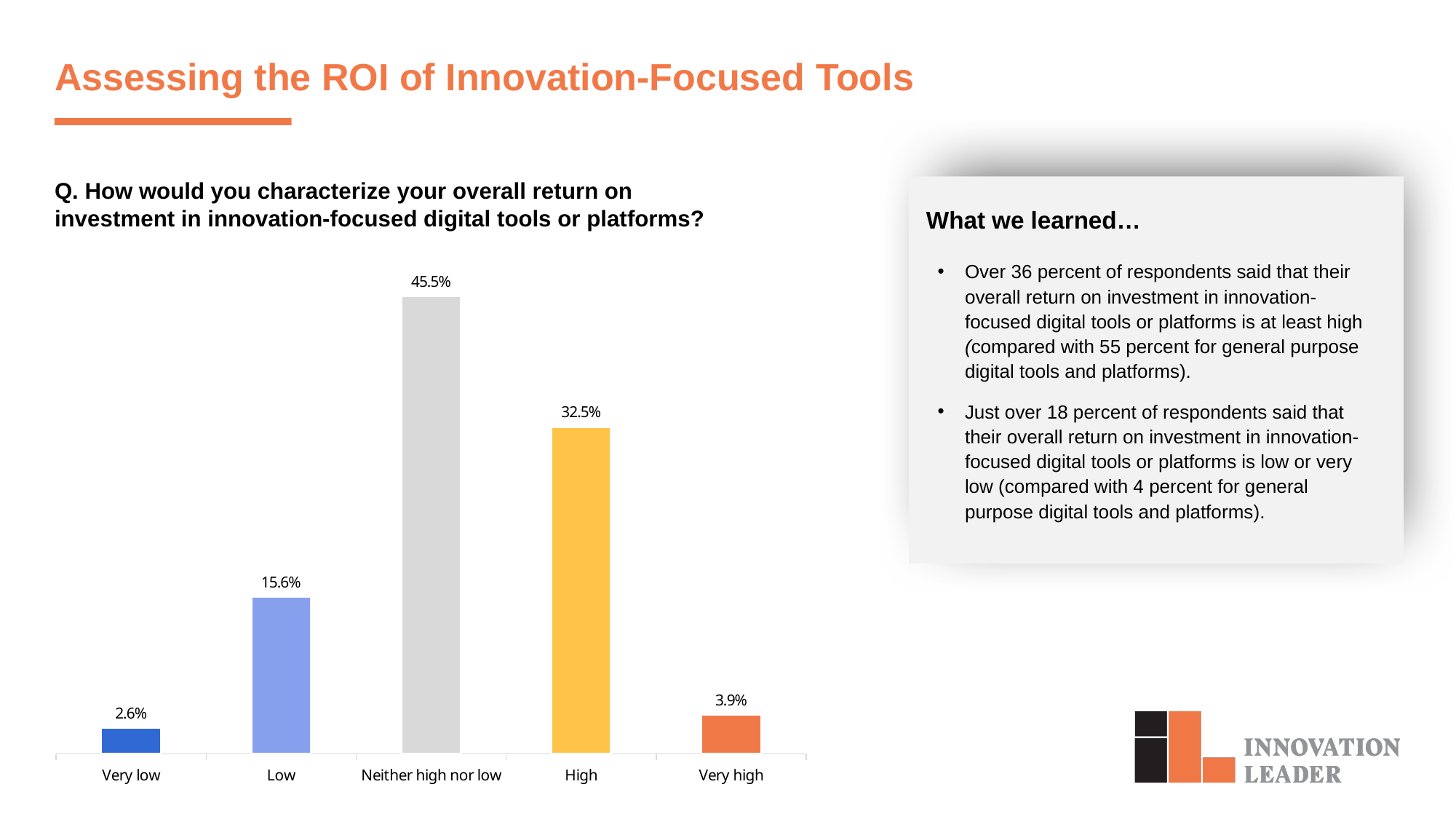
What percentage of respondents said their ROI was "Very low"? 2.6% What percentage of respondents characterized their overall ROI as "Neither high nor low"? 45.5% How many categories are shown on the x axis of the chart? 5 What is the value shown for the "High" category? 32.5% What is the value for the "Very high" category? 3.9% What colour is the bar for the "High" category? Yellow Which category has the highest value in the chart? Neither high nor low Which category has the lowest value in the chart? Very low What type of chart is shown on the slide? Bar chart What is the difference between the "Low" and "Very low" values? 13.0% Which is larger, the value for "Low" or the value for "Very high"? Low What is the difference between the "Neither high nor low" and "High" values? 13.0%